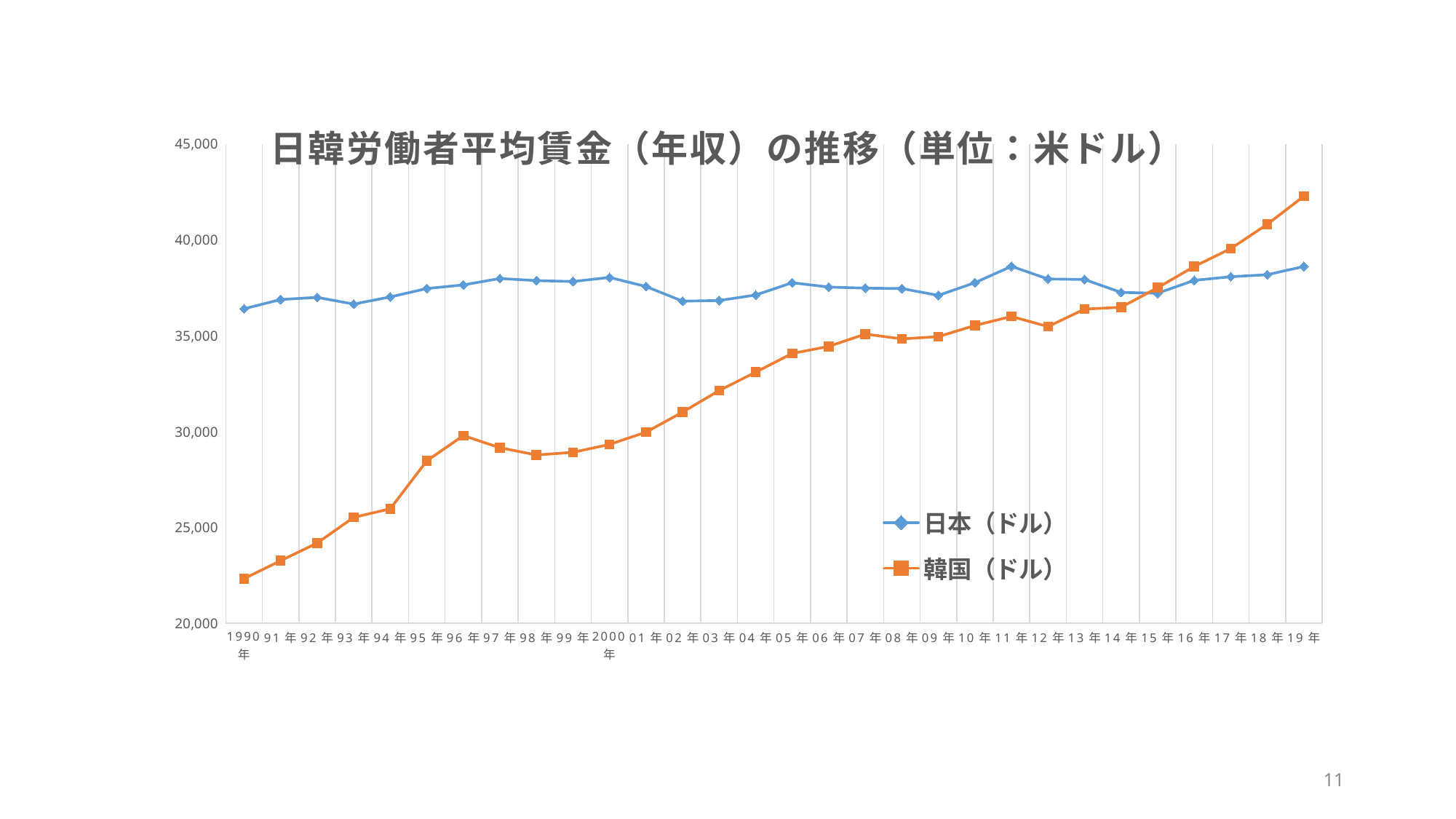
What kind of chart is shown on the slide? line chart In which year is the 韓国（ドル） value highest? 19年 Does the 韓国（ドル） series generally rise or fall from 1990年 to 19年? rise In 19年, which series has the larger value, 日本（ドル） or 韓国（ドル）? 韓国（ドル） Is the 日本（ドル） value for 1990年 greater or less than 40,000? less How many years (data points) are plotted along the x axis? 30 Is the 韓国（ドル） value for 19年 greater or less than 40,000? greater Is the 韓国（ドル） value for 1990年 greater or less than 25,000? less How many series does the legend list? 2 In 1990年, which series has the larger value, 日本（ドル） or 韓国（ドル）? 日本（ドル） In which year is the 韓国（ドル） value lowest? 1990年